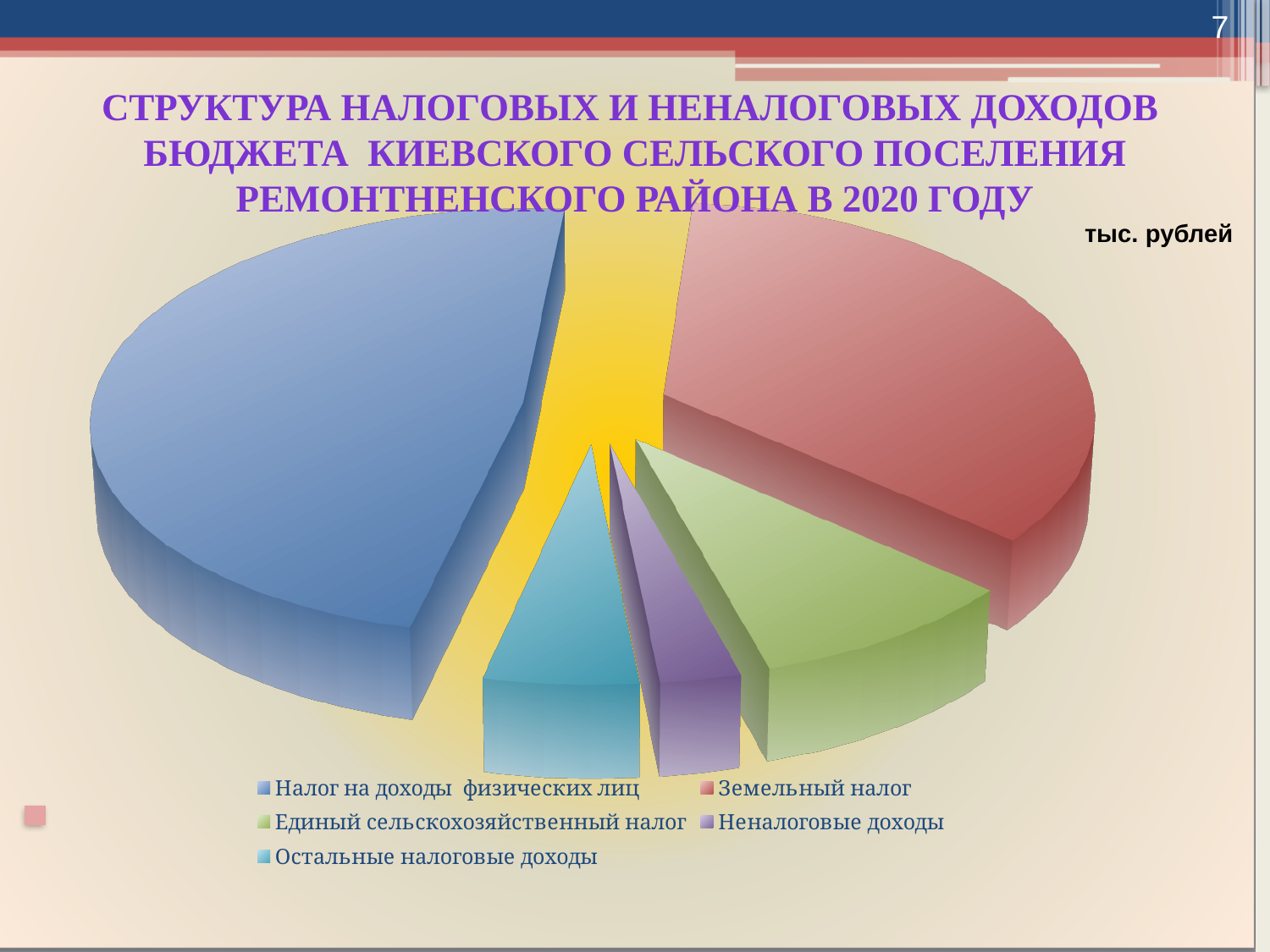
What kind of chart is shown on the slide? pie chart Which slice is larger: Земельный налог or Единый сельскохозяйственный налог? Земельный налог Which slice is larger: Остальные налоговые доходы or Неналоговые доходы? Остальные налоговые доходы How many slices does the pie chart have? 5 Which slice is larger: Налог на доходы физических лиц or Земельный налог? Налог на доходы физических лиц In what units are the values of the chart expressed, according to the slide? тыс. рублей How many entries does the legend of the pie chart list? 5 Which category has the smallest slice in the pie chart? Неналоговые доходы Which category has the largest slice in the pie chart? Налог на доходы физических лиц What colour is the slice for Земельный налог in the pie chart? red